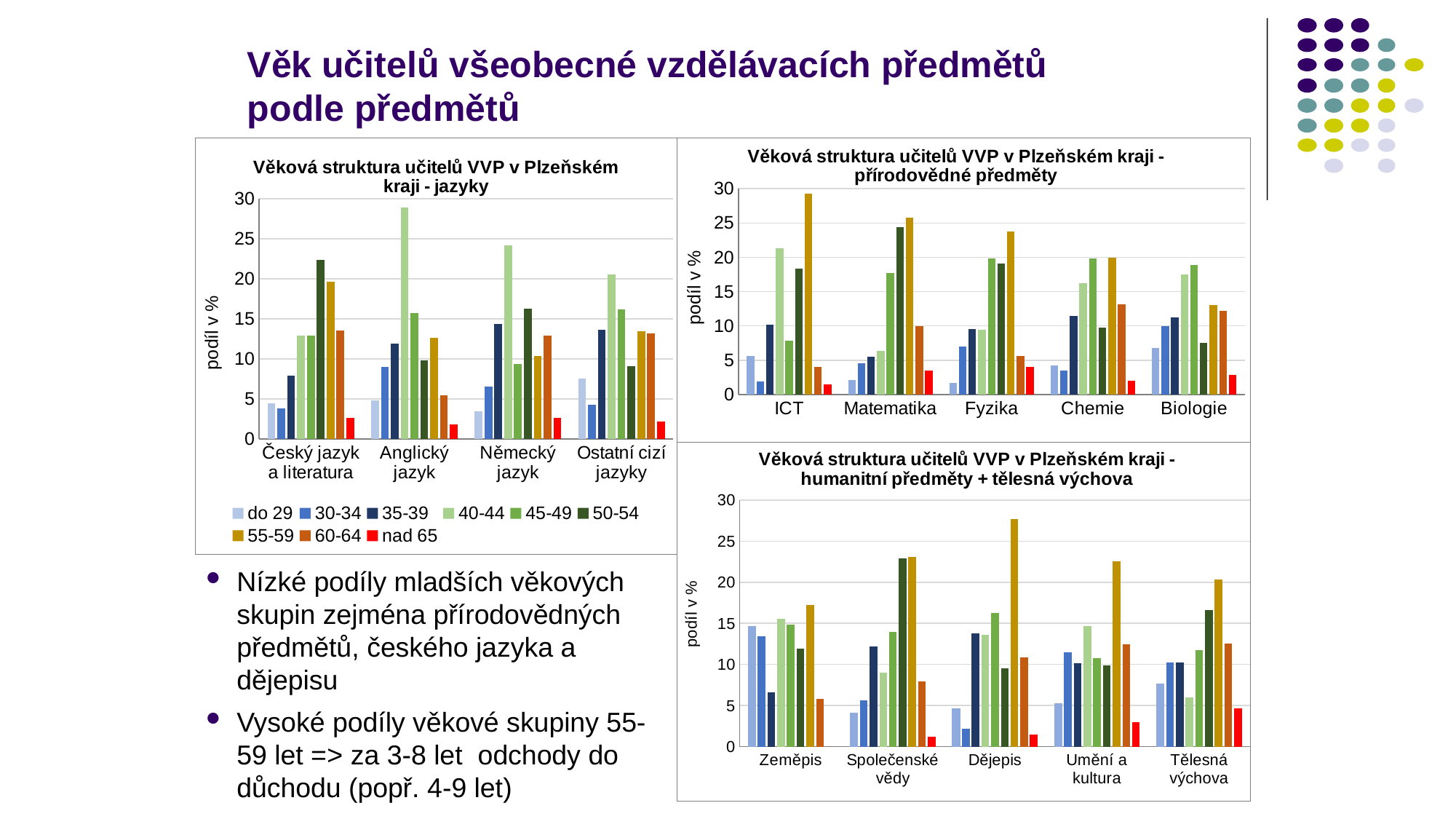
In the 'humanitní předměty + tělesná výchova' chart, which category contains the tallest bar? Dějepis How many series does the legend of the 'jazyky' chart list? 9 In the 'jazyky' chart, is the value of the 50-54 series for Český jazyk a literatura greater or less than 20? greater What kind of chart is the 'Věková struktura učitelů VVP v Plzeňském kraji - jazyky' chart? bar chart How many categories are shown on the x axis of the 'jazyky' chart? 4 In the 'přírodovědné předměty' chart, which category contains the tallest bar? ICT In the 'jazyky' chart, is the value of the 40-44 series for Anglický jazyk greater or less than 25? greater In the 'jazyky' chart, is the value of the 'do 29' series for Ostatní cizí jazyky greater or less than 5? greater How many categories are shown on the x axis of the 'přírodovědné předměty' chart? 5 What is the y-axis label of the 'humanitní předměty + tělesná výchova' chart? podíl v % In the 'jazyky' chart, which category has the highest value for the 40-44 series? Anglický jazyk In the 'jazyky' chart, which has the larger 50-54 value: Český jazyk a literatura or Anglický jazyk? Český jazyk a literatura